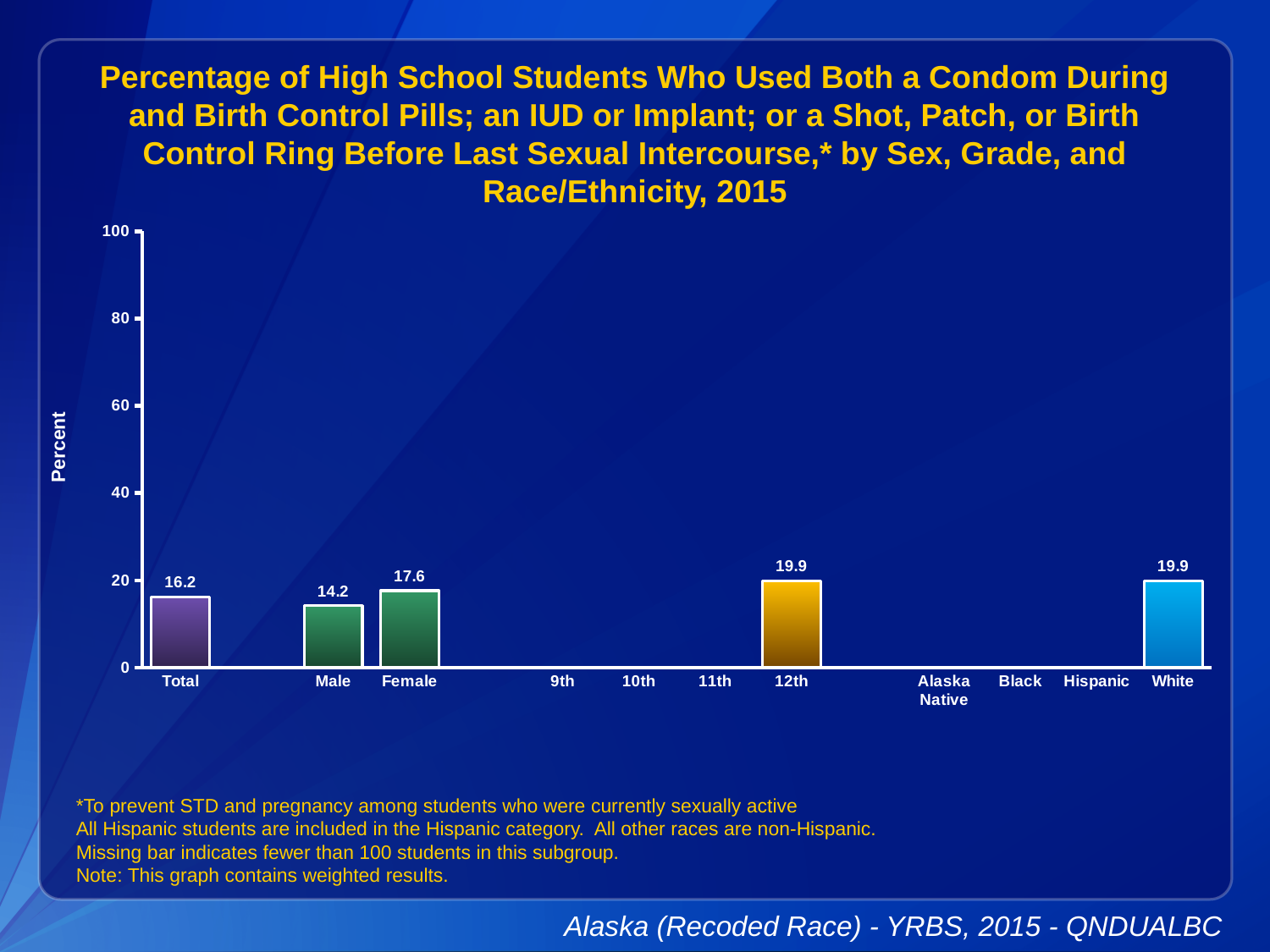
What is the difference between the Female and Male values? 3.4 What is the value for Male? 14.2 What is the value for Female? 17.6 What kind of chart is shown? bar chart What is the value for White? 19.9 What is the value for 12th grade? 19.9 Is the value for 12th grade greater or less than 40? less Which has the lowest value among the bars shown? Male How many categories are labeled on the x axis? 11 Which is larger, the value for Female or the value for Total? Female What is the value for Total? 16.2 What is the label of the y axis? Percent